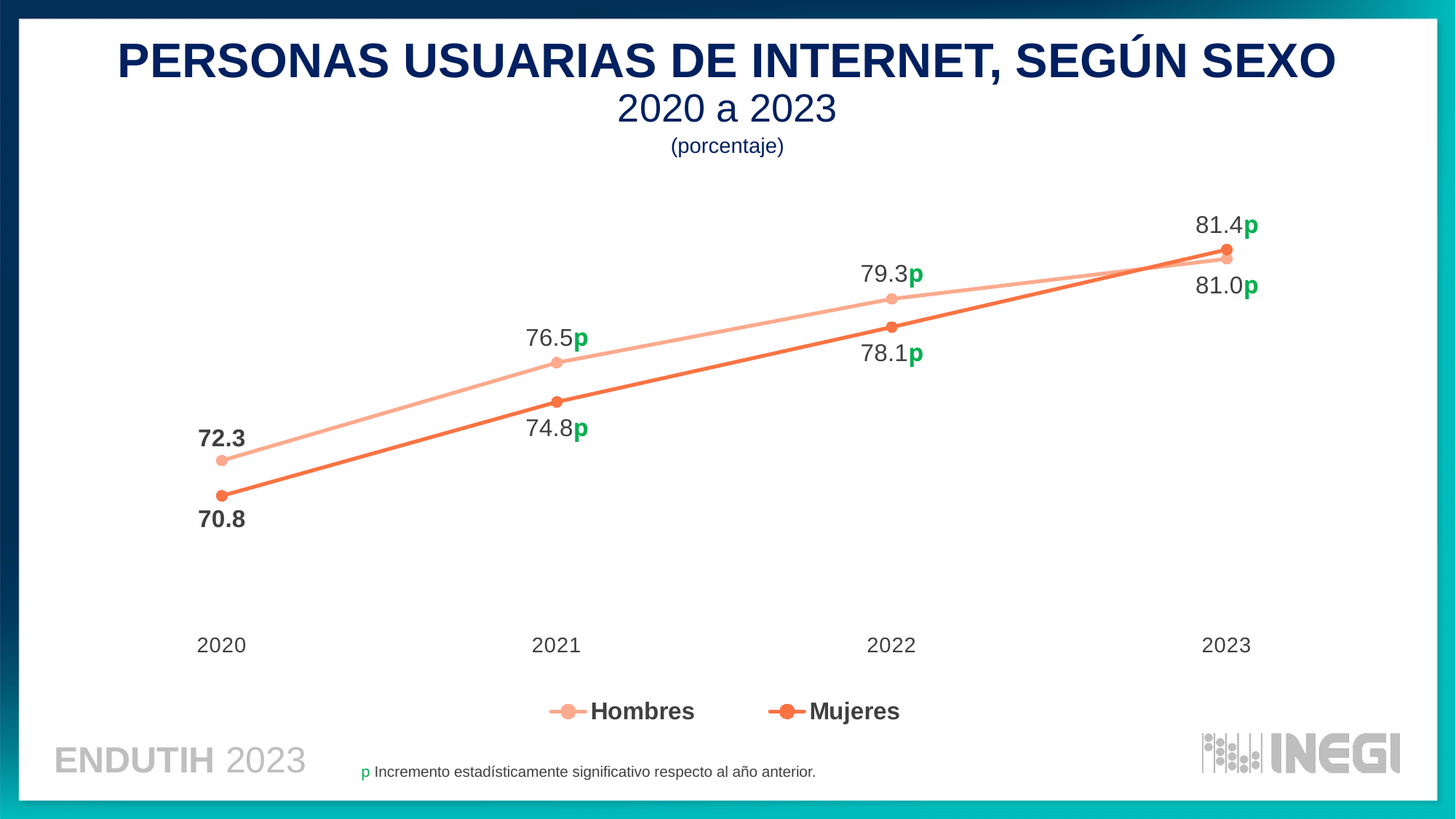
In which year is the value for Hombres lowest? 2020 How many series does the legend list? 2 What is the difference between the Hombres and Mujeres values in 2021? 1.7 What is the value for Mujeres in 2020? 70.8 In which year is the value for Mujeres highest? 2023 What is the value for Hombres in 2023? 81.0 Which series has the larger value in 2022, Hombres or Mujeres? Hombres Do the values for Mujeres rise or fall from 2020 to 2023? Rise What is the value for Hombres in 2020? 72.3 What kind of chart is shown on the slide? Line chart What is the value for Mujeres in 2022? 78.1 How many years are shown on the x axis? 4